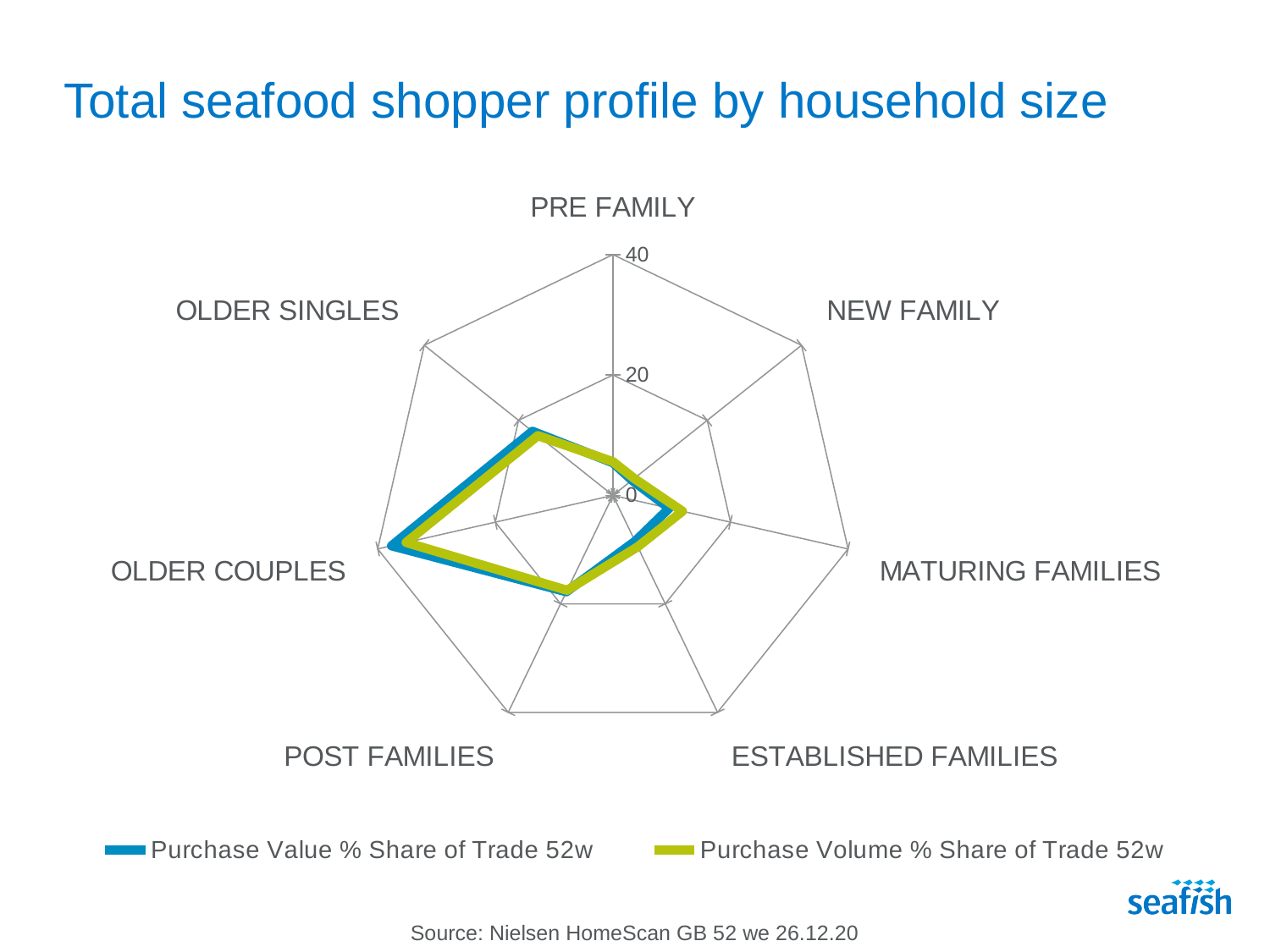
What is the title of the chart? Total seafood shopper profile by household size Is the Purchase Volume % Share of Trade 52w for MATURING FAMILIES greater or less than 20? less Which household size category has the highest Purchase Volume % Share of Trade 52w? OLDER COUPLES Which has the larger Purchase Value % Share of Trade 52w, OLDER COUPLES or MATURING FAMILIES? OLDER COUPLES Is the Purchase Volume % Share of Trade 52w for OLDER COUPLES greater or less than 40? less Which household size category has the highest Purchase Value % Share of Trade 52w? OLDER COUPLES What kind of chart is shown on the slide? Radar chart Is the Purchase Value % Share of Trade 52w for OLDER COUPLES greater or less than 20? greater How many series does the legend list? 2 How many household size categories are plotted on the radar chart? 7 Which colour represents Purchase Volume % Share of Trade 52w in the legend? Green